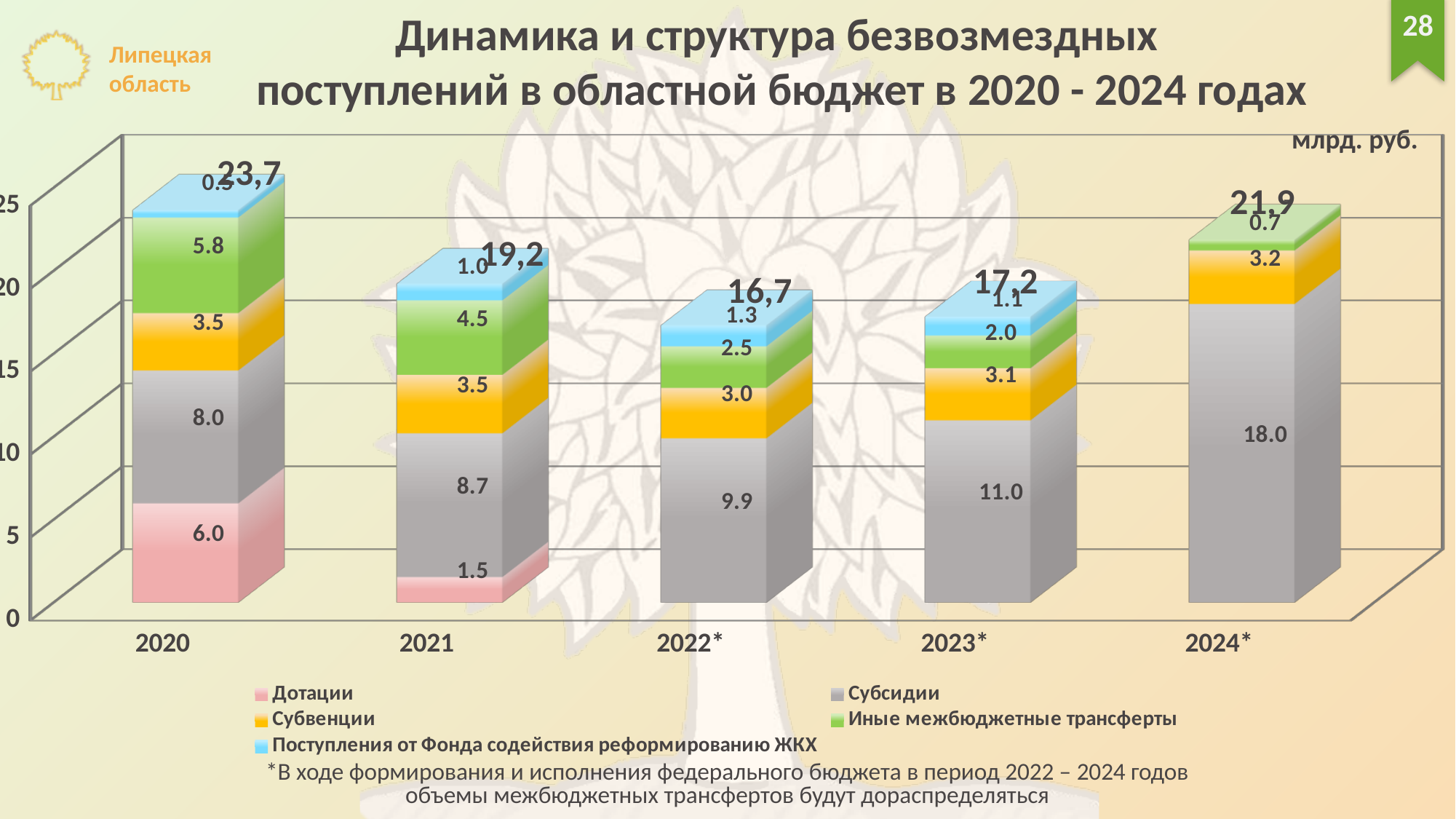
How many series does the legend list? 5 What is the value of the Иные межбюджетные трансферты segment for 2022*? 2.5 What is the value of the Поступления от Фонда содействия реформированию ЖКХ segment for 2023*? 1.1 What is the value of the Субсидии segment for 2024*? 18.0 What kind of chart is shown on the slide? Stacked bar chart What is the total value shown above the bar for 2020? 23,7 How many years are shown on the x axis? 5 What is the value of the Дотации segment for 2021? 1.5 What is the difference between the Субсидии values for 2024* and 2023*? 7.0 Which year has the lowest total of безвозмездные поступления? 2022* Which year has the highest total of безвозмездные поступления? 2020 Which is larger, the Субвенции value for 2020 or for 2022*? 2020